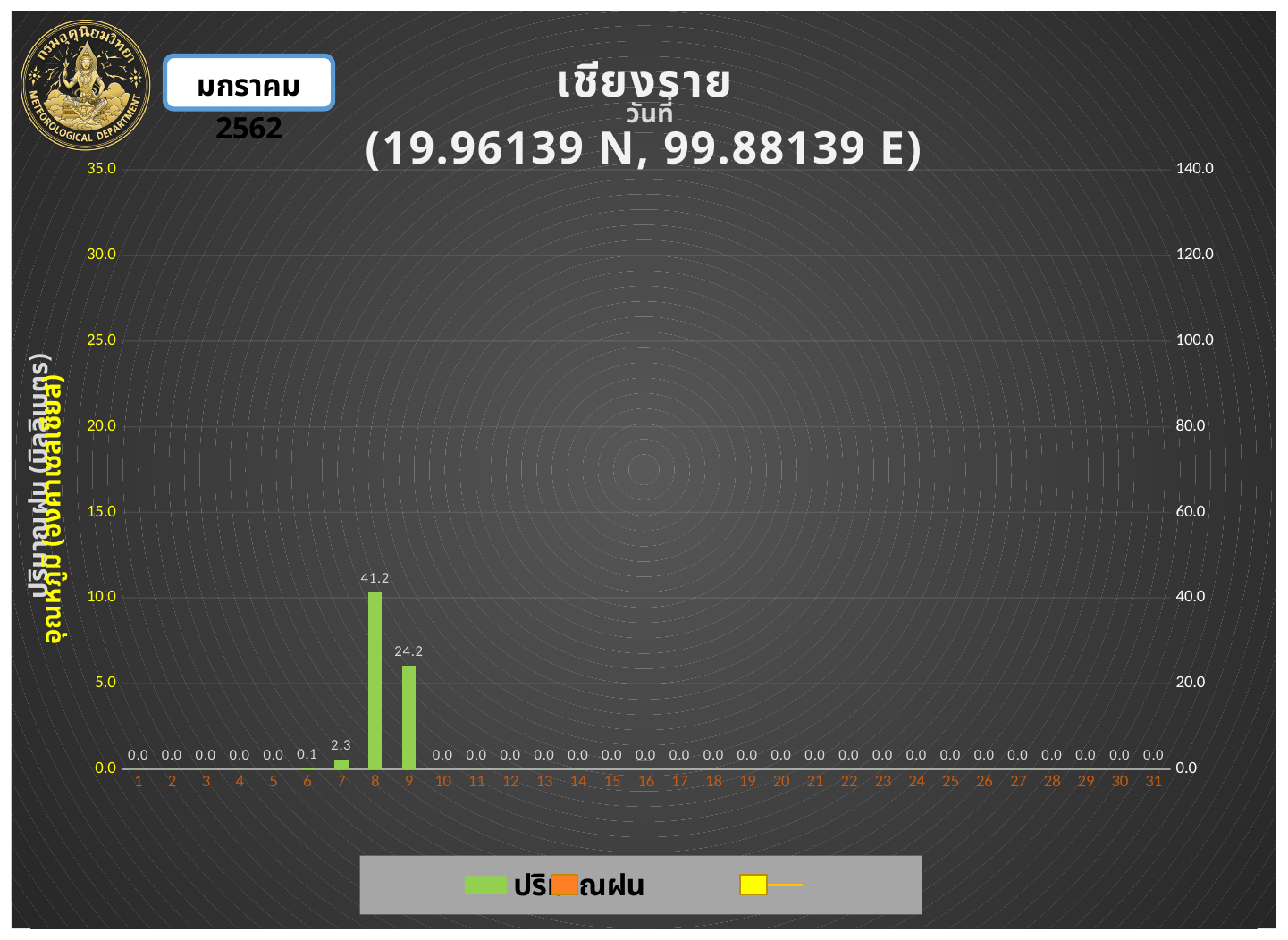
What coordinates are given in the chart title? 19.96139 N, 99.88139 E What is the value shown for day 6? 0.1 Which is larger, the value for day 7 or the value for day 9? day 9 What is the difference between the values for day 8 and day 9? 17.0 What is the value shown for day 15? 0.0 What is the value shown for day 9? 24.2 Which day has the highest value? 8 How many days are shown on the x axis? 31 From day 6 to day 8, do the values rise or fall? rise What is the value shown for day 8? 41.2 What kind of chart is this? bar chart What is the value shown for day 7? 2.3